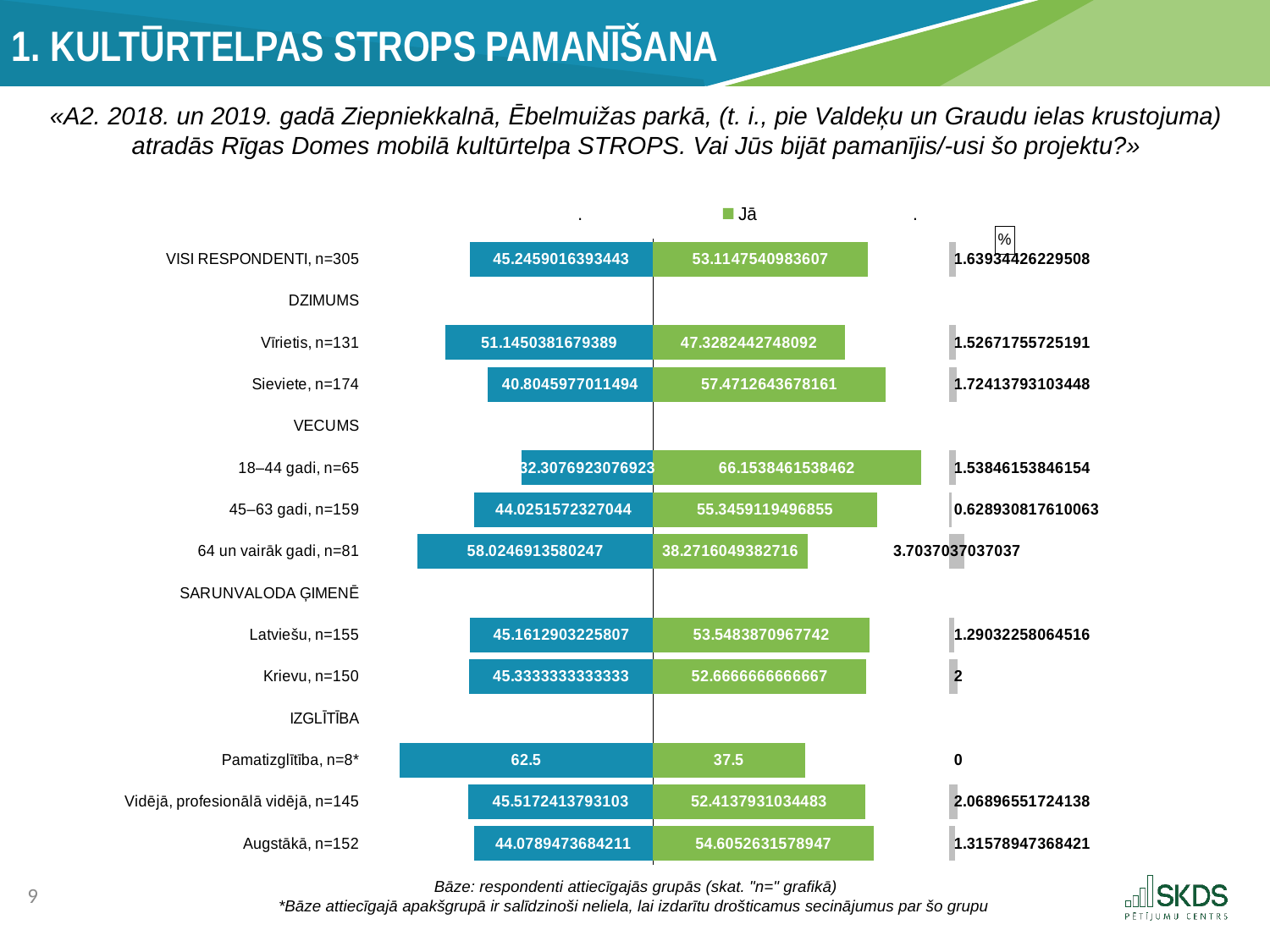
What is the value of the blue bar for 64 un vairāk gadi, n=81? 58.0246913580247 What is the total of the three bar values for Pamatizglītība, n=8*? 100 For Pamatizglītība, n=8*, what is the difference between the blue bar value and the "Jā" value? 25 Which category has the highest "Jā" value? 18–44 gadi, n=65 Which has the larger "Jā" value: 18–44 gadi, n=65 or 64 un vairāk gadi, n=81? 18–44 gadi, n=65 What type of chart is shown on the slide? bar chart What is the "Jā" value for Sieviete, n=174? 57.4712643678161 Which category has the highest value in the grey series? 64 un vairāk gadi, n=81 Which category has the lowest "Jā" value? Pamatizglītība, n=8* What is the "Jā" value for VISI RESPONDENTI, n=305? 53.1147540983607 What is the value of the grey bar for Krievu, n=150? 2 How many respondent groups (rows with bars) are plotted in the chart? 11